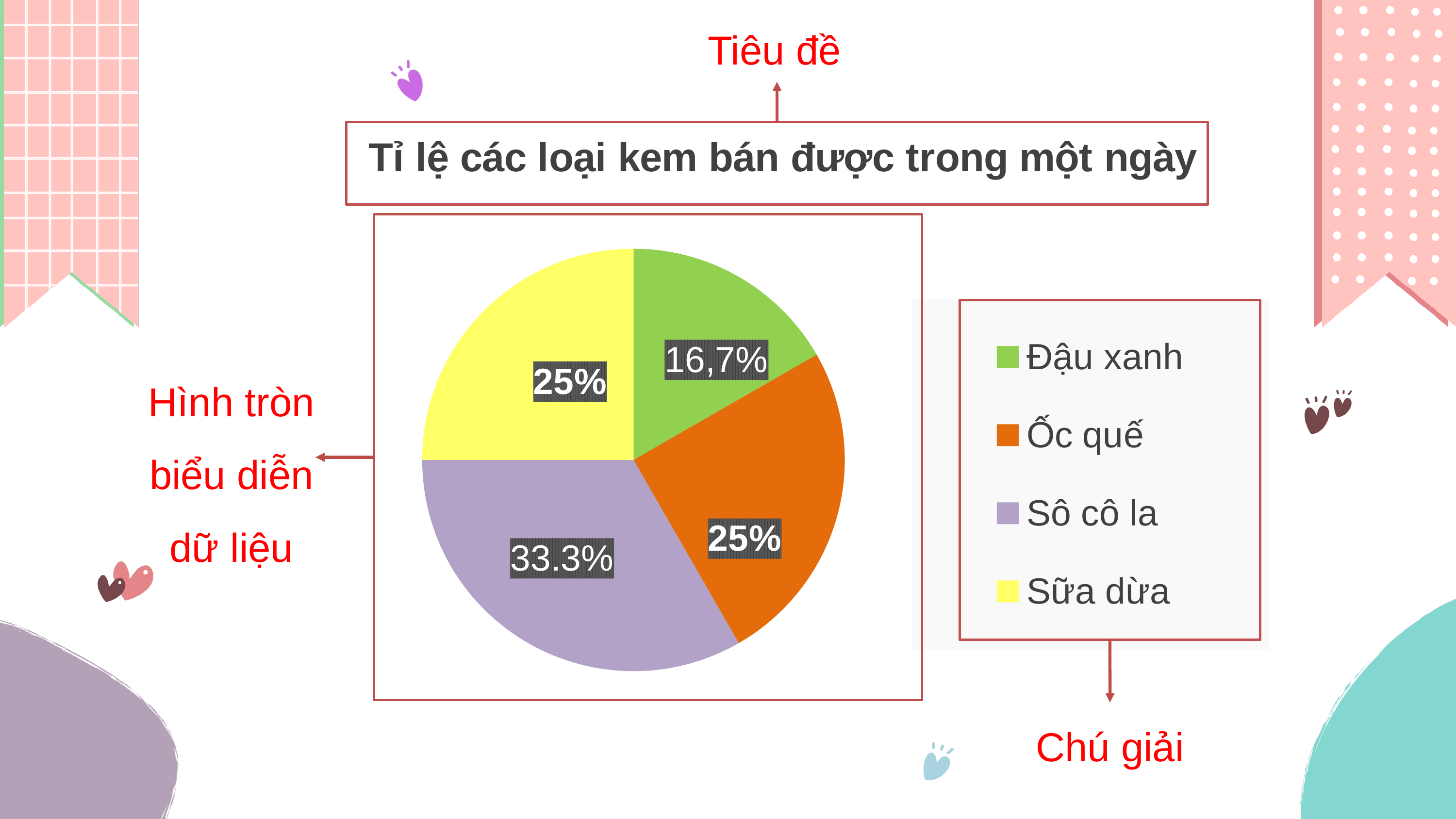
What share of the pie does Sữa dừa have? 25% What share of the pie does Đậu xanh have? 16,7% What share of the pie does Sô cô la have? 33.3% What is the title of the chart? Tỉ lệ các loại kem bán được trong một ngày Which ice cream type has the largest share of the pie? Sô cô la Is the share for Sô cô la greater or less than 25%? greater Which ice cream type has the smallest share of the pie? Đậu xanh Which has a larger share, Sô cô la or Đậu xanh? Sô cô la How many categories does the legend list? 4 What kind of chart is shown on the slide? pie chart Which colour represents Sữa dừa in the chart? yellow What share of the pie does Ốc quế have? 25%